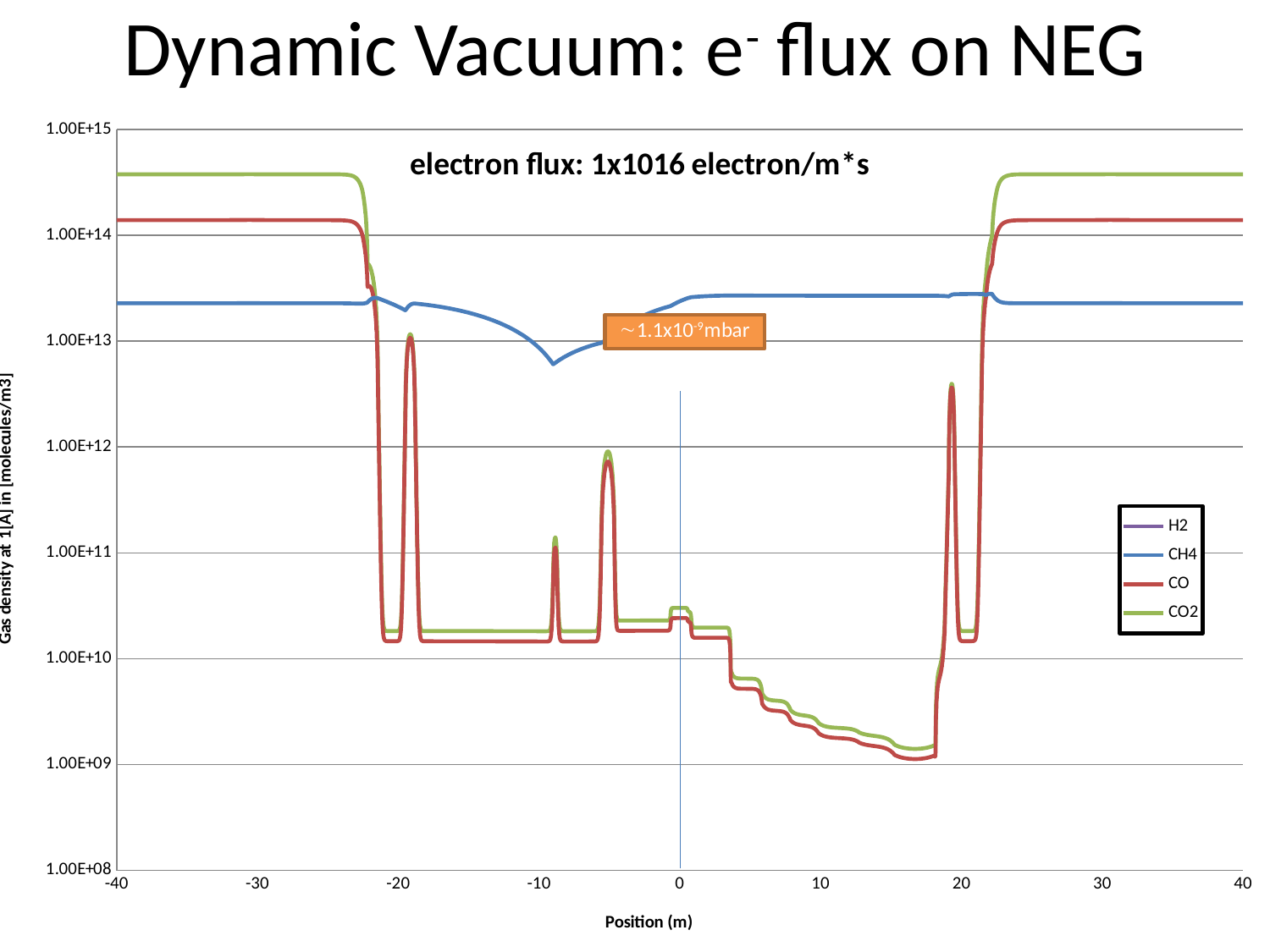
At position -40 m, is the CH4 value greater or less than 1.00E+13? greater At position 0 m, is the CO value greater or less than 1.00E+10? greater At position -40 m, is the CO2 value greater or less than 1.00E+14? greater Does the CH4 curve rise or fall as position goes from -20 m to -10 m? fall At position -40 m, which is larger, the CO value or the CH4 value? CO What is the title shown inside the chart area? electron flux: 1x1016 electron/m*s What kind of chart is shown on the slide? line chart How many series does the legend list? 4 What is the title of the x axis? Position (m)